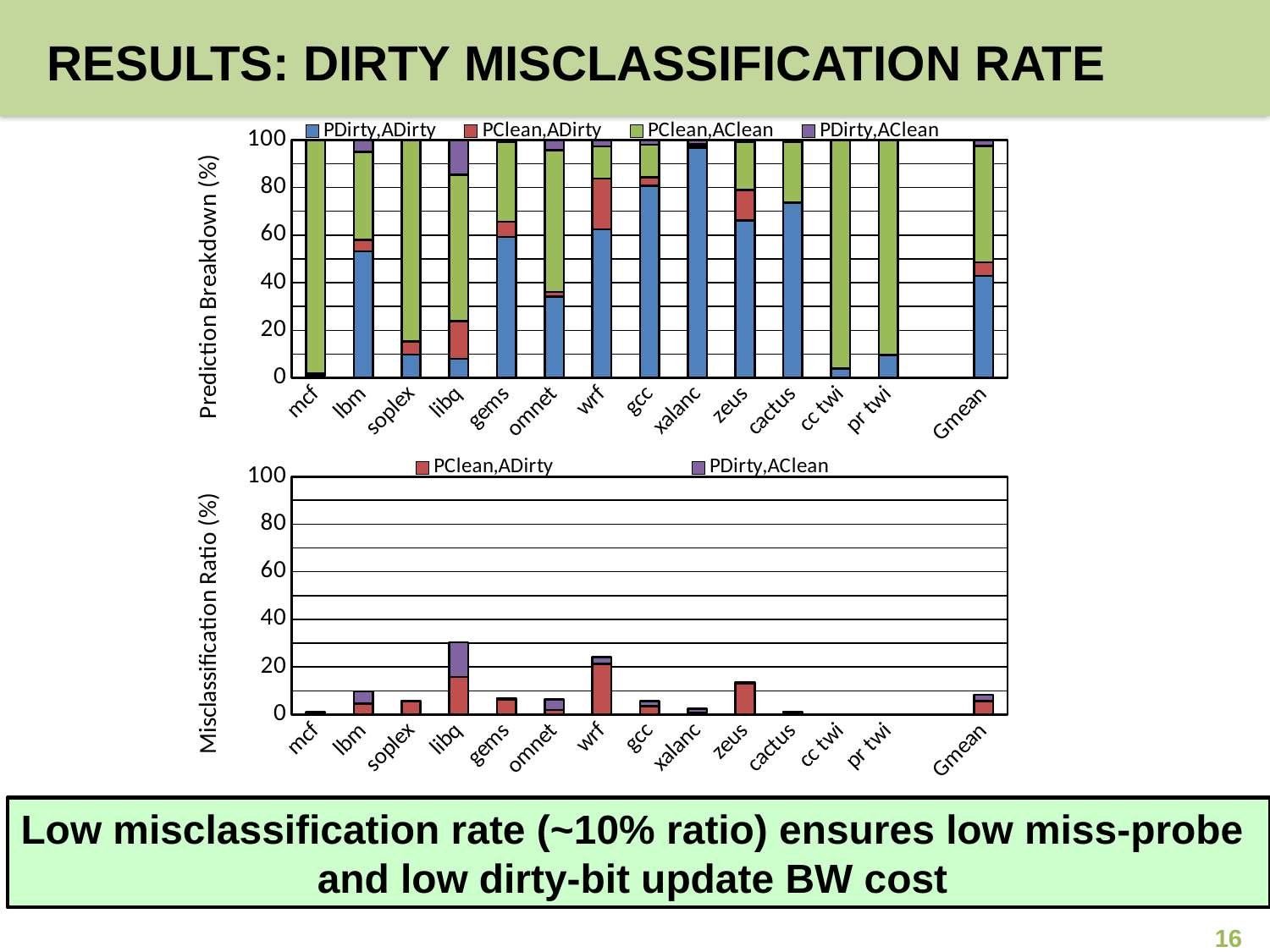
How many series does the legend of the top chart (Prediction Breakdown) list? 4 What is the y-axis label of the bottom chart? Misclassification Ratio (%) In the bottom chart (Misclassification Ratio), which has the larger total, libq or zeus? libq In the bottom chart (Misclassification Ratio), which category has the tallest stacked bar? libq What kind of chart is the top chart (Prediction Breakdown)? bar chart In the top chart (Prediction Breakdown), is the PDirty,ADirty value for soplex greater or less than 20? less In the bottom chart (Misclassification Ratio), is the total for zeus greater or less than 10? greater In the bottom chart (Misclassification Ratio), is the total for libq greater or less than 20? greater How many categories are shown on the x axis of the bottom chart (Misclassification Ratio)? 14 In the top chart (Prediction Breakdown), which category has the largest PDirty,ADirty segment? xalanc How many series does the legend of the bottom chart (Misclassification Ratio) list? 2